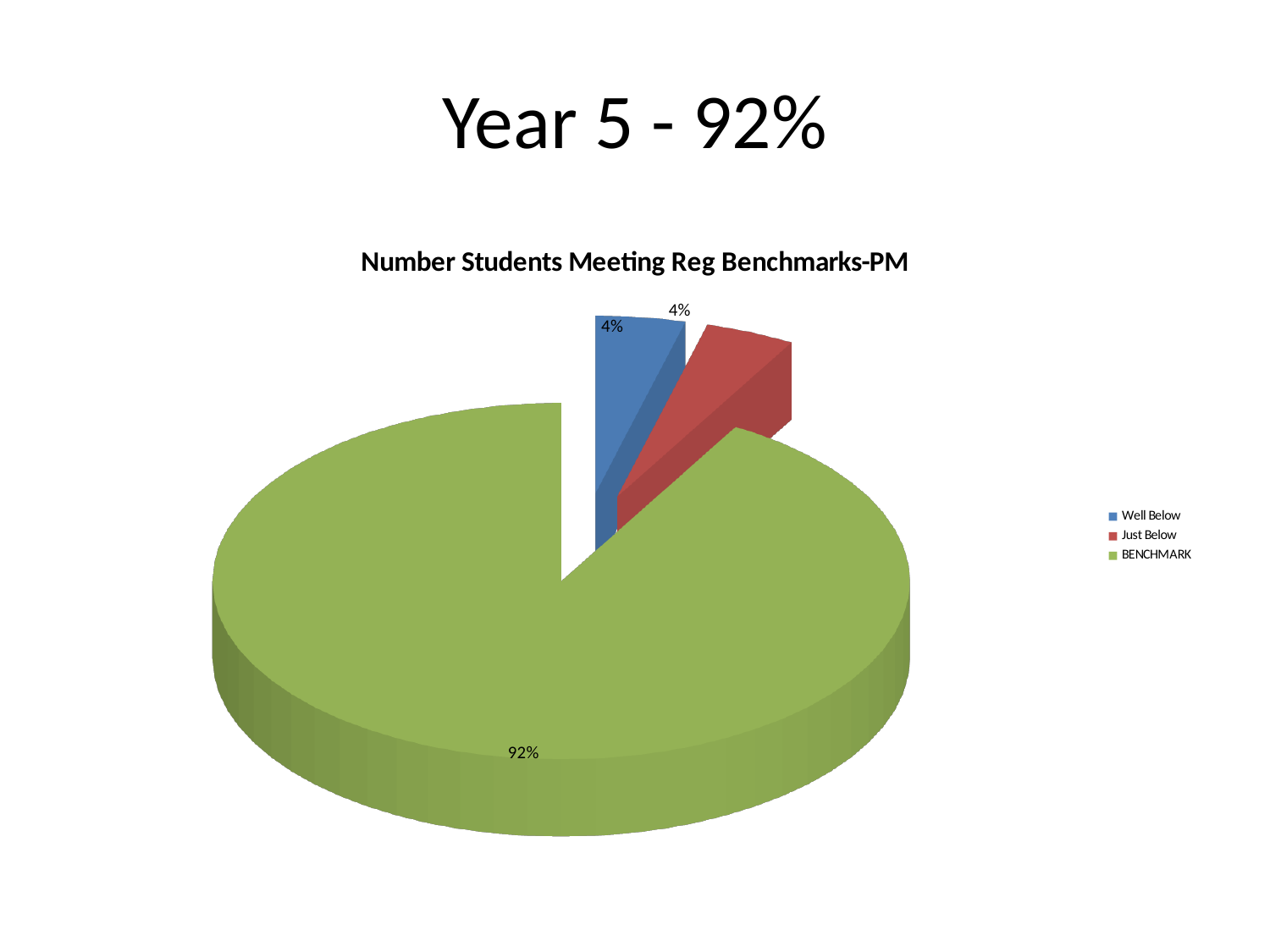
What is the title of the chart? Number Students Meeting Reg Benchmarks-PM Which is larger, the BENCHMARK slice or the Just Below slice? BENCHMARK What colour is the BENCHMARK slice? green What type of chart is shown on the slide? pie chart Which category has the largest slice of the pie? BENCHMARK What share of the pie does the Well Below slice represent? 4% How many categories does the legend list? 3 What share of the pie does the Just Below slice represent? 4% What share of the pie does the BENCHMARK slice represent? 92% How many slices does the pie chart have? 3 What is the difference between the BENCHMARK share and the Well Below share? 88% What is the combined share of the Well Below and Just Below slices? 8%